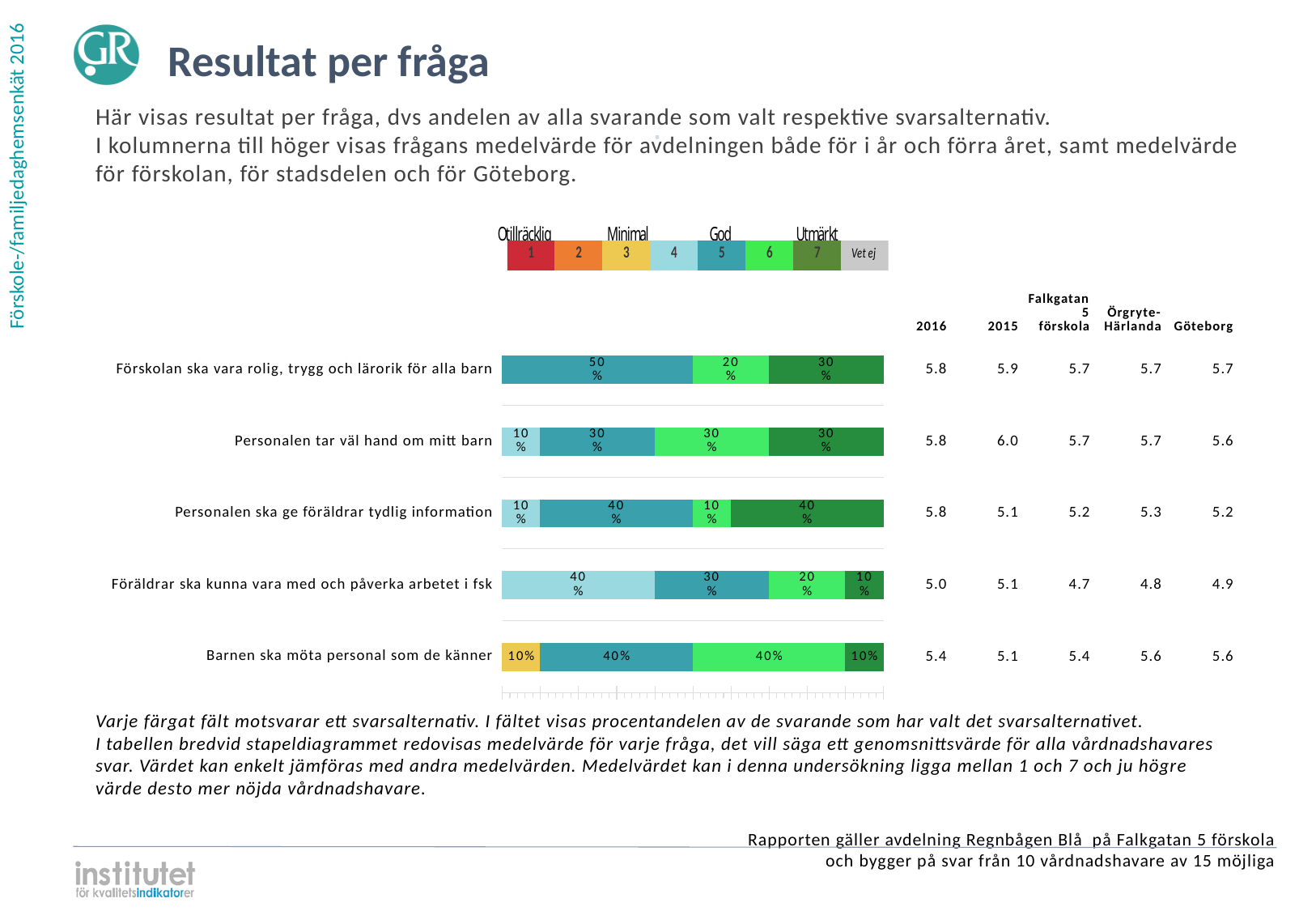
What percentage of respondents chose answer 5 for 'Förskolan ska vara rolig, trygg och lärorik för alla barn'? 50% How many entries does the colour legend above the chart list? 8 What percentage of respondents chose answer 7 for 'Personalen ska ge föräldrar tydlig information'? 40% For 'Personalen ska ge föräldrar tydlig information', which is larger: the share for answer 5 or the share for answer 6? Answer 5 What is the 2016 mean value shown for 'Föräldrar ska kunna vara med och påverka arbetet i fsk'? 5.0 What percentage of respondents chose answer 4 for 'Föräldrar ska kunna vara med och påverka arbetet i fsk'? 40% How many questions (categories) are plotted in the bar chart? 5 What kind of chart is shown on the slide? Stacked bar chart What is the difference between the share for answer 7 and the share for answer 6 in 'Förskolan ska vara rolig, trygg och lärorik för alla barn'? 10% Which answer alternative has the largest share for 'Föräldrar ska kunna vara med och påverka arbetet i fsk'? 4 What percentage of respondents chose answer 3 for 'Barnen ska möta personal som de känner'? 10% What is the total of the stacked bar for 'Personalen tar väl hand om mitt barn'? 100%